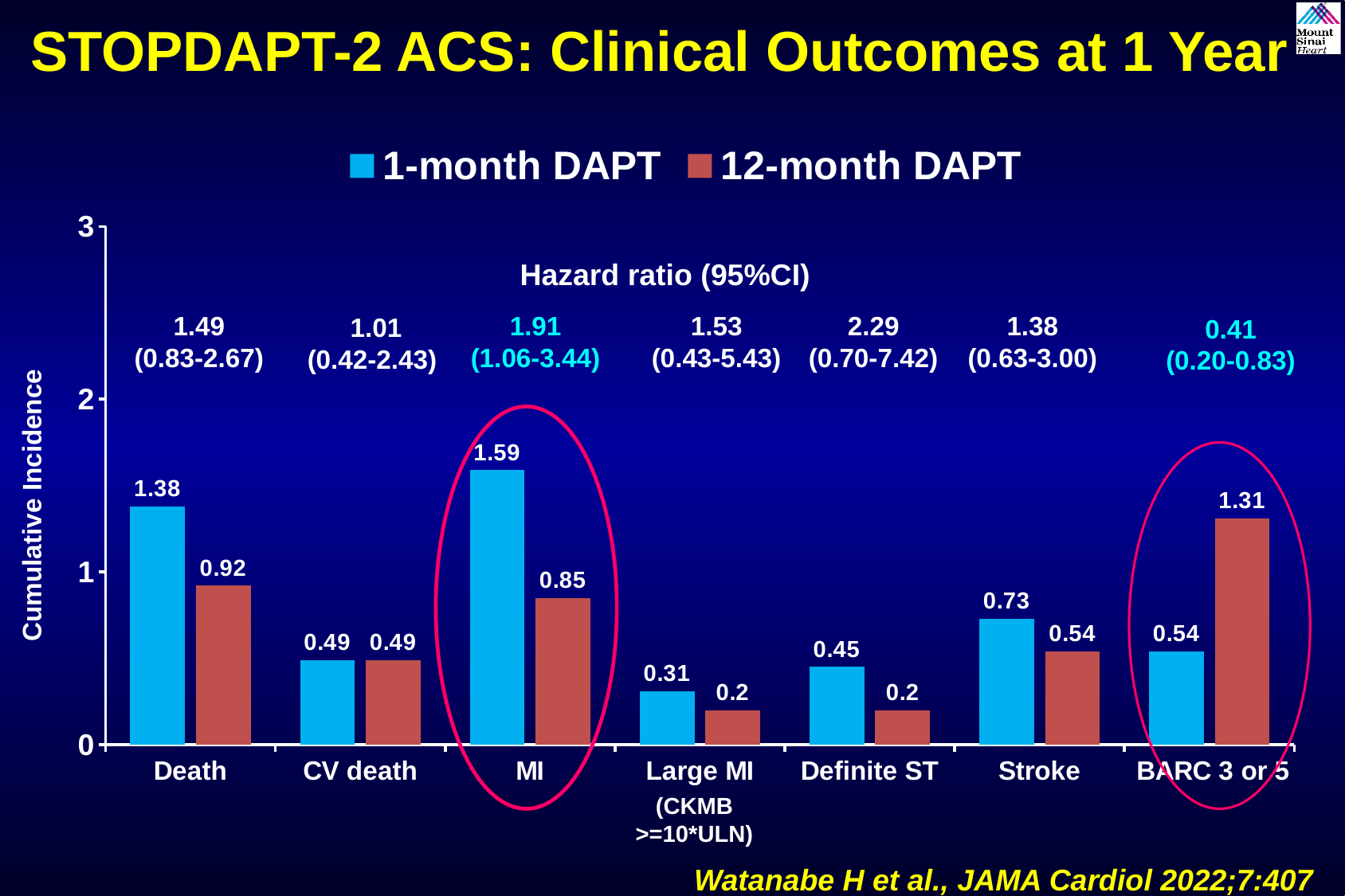
What is the cumulative incidence of BARC 3 or 5 bleeding in the 12-month DAPT group? 1.31 What is the cumulative incidence of Death in the 12-month DAPT group? 0.92 What is the hazard ratio (95% CI) shown for MI? 1.91 (1.06-3.44) What kind of chart is shown on the slide? Bar chart For BARC 3 or 5, which group has the higher cumulative incidence, 1-month DAPT or 12-month DAPT? 12-month DAPT What is the difference in cumulative incidence of MI between the 1-month DAPT and 12-month DAPT groups? 0.74 Which outcome has the highest cumulative incidence in the 1-month DAPT group? MI Which outcome has the lowest cumulative incidence in the 1-month DAPT group? Large MI (CKMB >=10*ULN) How many series does the legend list? 2 What is the label of the y axis? Cumulative Incidence How many outcome categories are shown on the x axis? 7 What is the cumulative incidence of MI in the 1-month DAPT group? 1.59